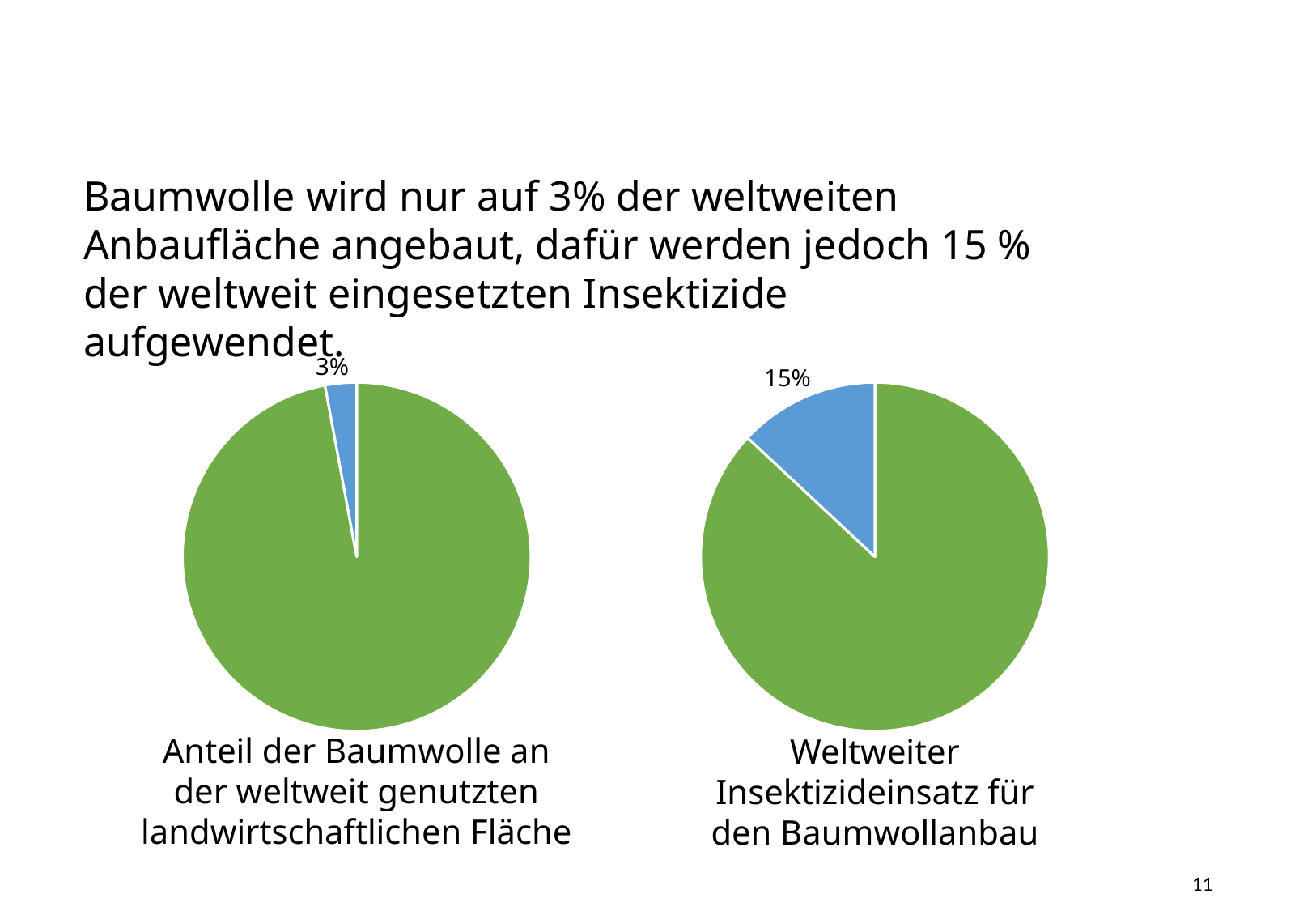
How many slices does the right pie chart (Weltweiter Insektizideinsatz für den Baumwollanbau) have? 2 What colour is the largest slice in both pie charts? Green What is the difference in percentage points between the labelled slice of the right pie chart (15%) and the labelled slice of the left pie chart (3%)? 12 percentage points In the right pie chart (Weltweiter Insektizideinsatz für den Baumwollanbau), what value is printed on the blue slice? 15% Which chart has the larger labelled blue slice, the left one (Anteil der Baumwolle an der weltweit genutzten landwirtschaftlichen Fläche) or the right one (Weltweiter Insektizideinsatz für den Baumwollanbau)? The right one (Weltweiter Insektizideinsatz für den Baumwollanbau) What is the title of the right pie chart? Weltweiter Insektizideinsatz für den Baumwollanbau What kind of chart is the right chart titled "Weltweiter Insektizideinsatz für den Baumwollanbau"? Pie chart What kind of chart is the left chart titled "Anteil der Baumwolle an der weltweit genutzten landwirtschaftlichen Fläche"? Pie chart In the left pie chart, is the labelled blue slice greater or less than 10%? less In the left pie chart (Anteil der Baumwolle an der weltweit genutzten landwirtschaftlichen Fläche), what value is printed on the blue slice? 3% In the right pie chart, is the labelled blue slice greater or less than 10%? greater How many slices does the left pie chart (Anteil der Baumwolle an der weltweit genutzten landwirtschaftlichen Fläche) have? 2